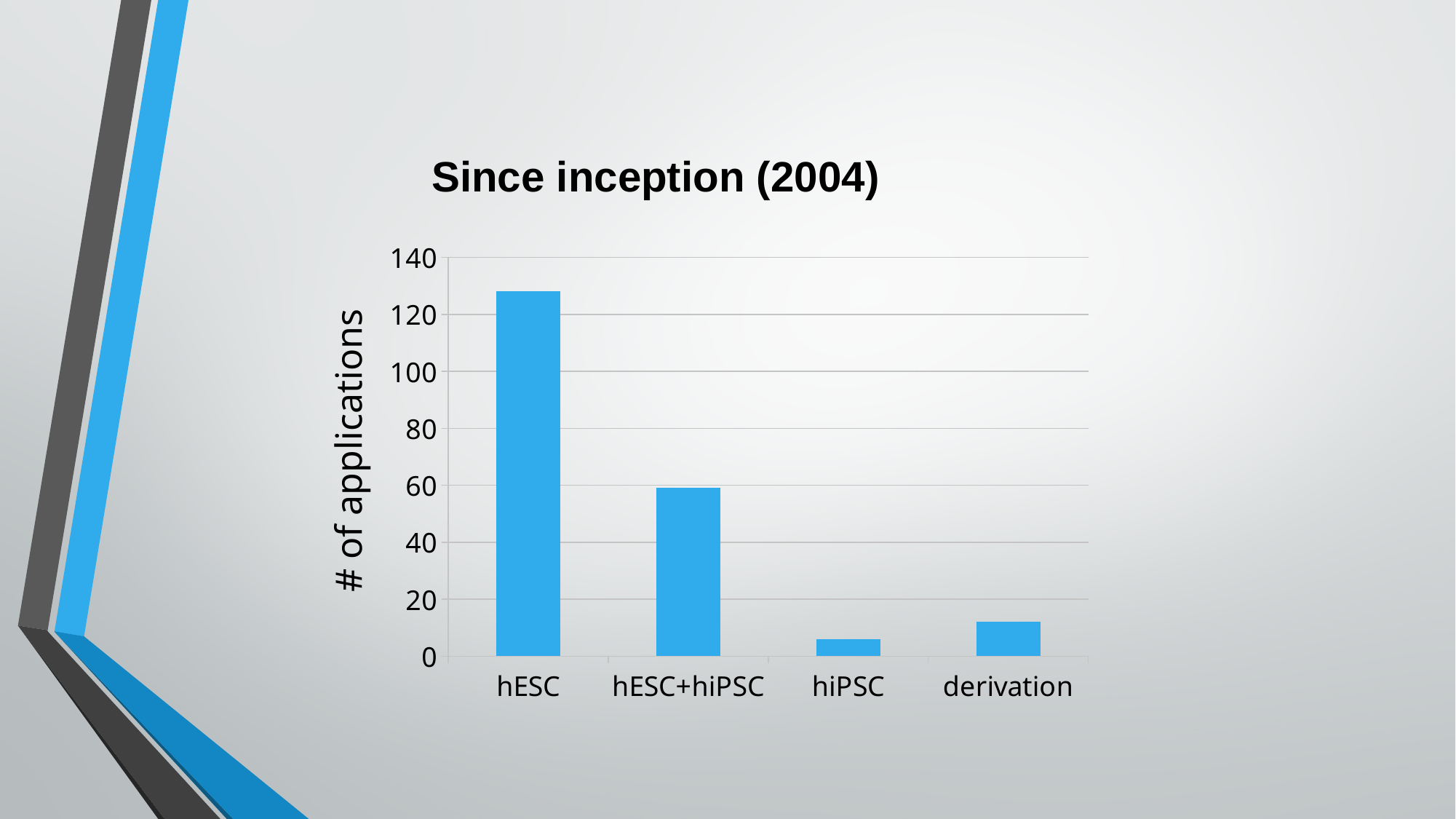
Which category has the lowest number of applications? hiPSC Is the value for hiPSC greater or less than 20? less What is the title of the chart? Since inception (2004) Which has more applications, derivation or hiPSC? derivation Is the value for derivation greater or less than 20? less Which category has the highest number of applications? hESC What is the label on the vertical axis? # of applications Is the value for hESC+hiPSC greater or less than 80? less How many categories are shown on the x axis? 4 What type of chart is shown on the slide? bar chart Which has more applications, hESC+hiPSC or derivation? hESC+hiPSC